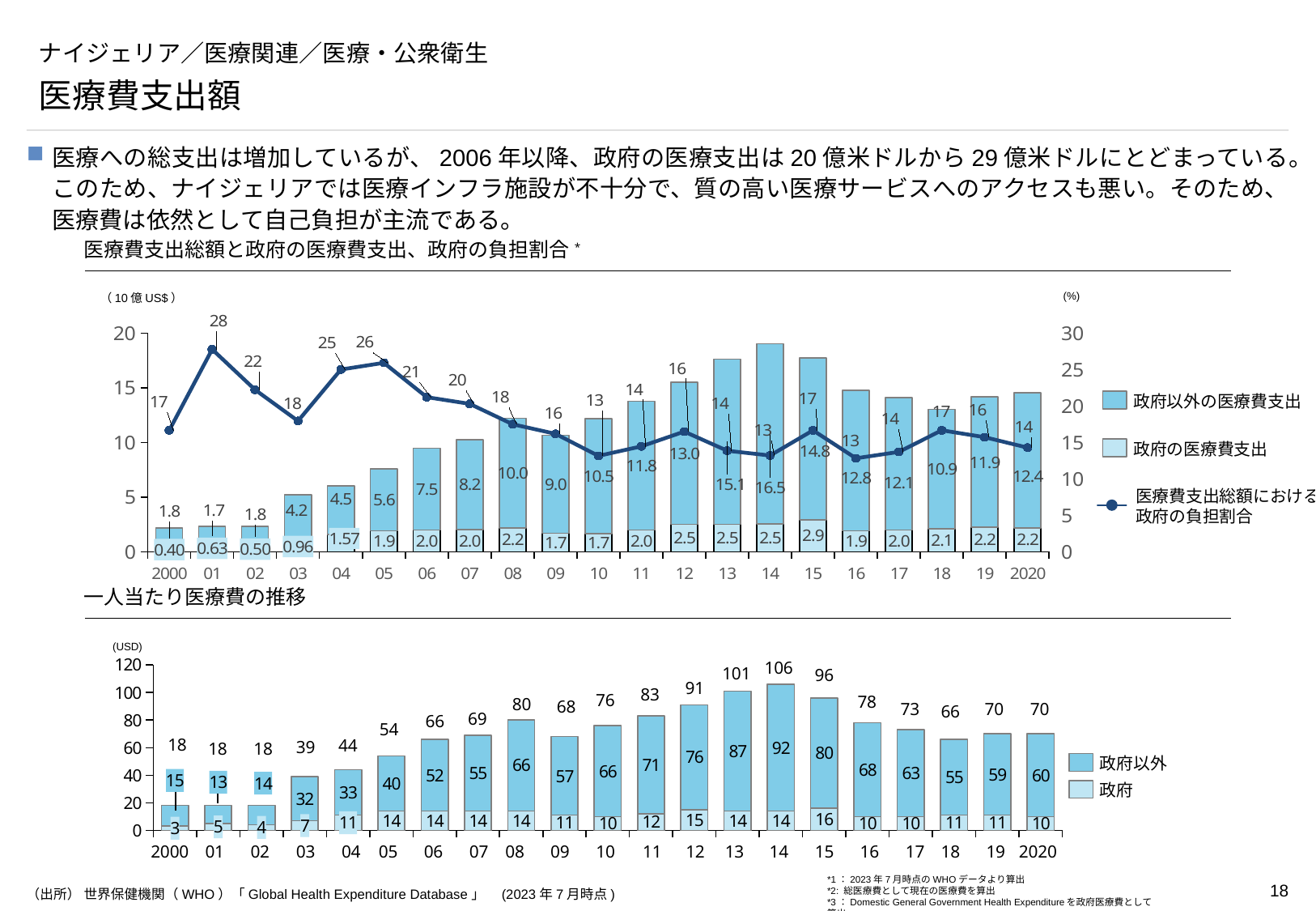
In the bottom chart, what is the 政府 value for 2015? 16 In the bottom chart, what is the total per-capita health expenditure for 2020? 70 How many years are shown on the x axis of the bottom chart? 21 In the top chart (医療費支出総額と政府の医療費支出、政府の負担割合), what is the value of 政府の医療費支出 for 2015? 2.9 In the bottom chart (一人当たり医療費の推移), which year has the highest total per-capita health expenditure? 14 In the top chart, what is the value of 政府以外の医療費支出 for 2014? 16.5 What kind of chart is the bottom chart (一人当たり医療費の推移)? Stacked bar chart In the top chart, which is larger: 政府以外の医療費支出 in 2013 or in 2015? 2013 In the top chart, how many series does the legend list? 3 In the top chart, what is the 政府の負担割合 value for 2010? 13 In the top chart, in which year does the 政府の負担割合 line reach its highest value? 01 In the bottom chart, what is the difference between the total per-capita expenditure in 2014 and in 2000? 88